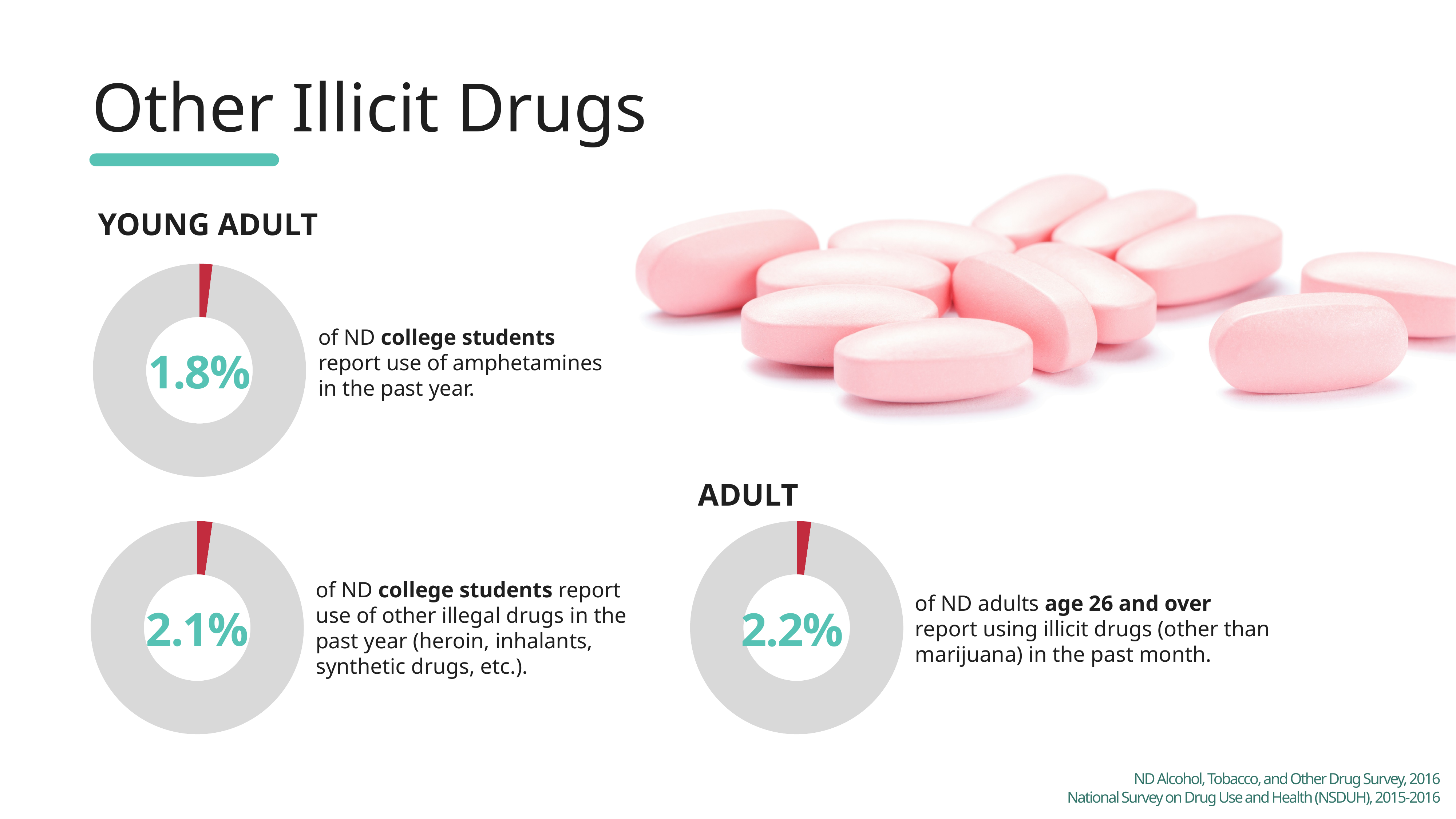
Of the three donut charts on the slide, which shows the highest percentage? The ADULT chart (2.2%) What is the difference in percentage points between the ADULT chart value (2.2%) and the top-left YOUNG ADULT amphetamine chart value (1.8%)? 0.4 percentage points How many donut charts are shown on the slide? 3 On the ADULT donut chart, what percentage of ND adults age 26 and over report using illicit drugs (other than marijuana) in the past month? 2.2% Is the value on the ADULT donut chart greater or less than 2%? greater What is the difference in percentage points between the two YOUNG ADULT donut charts (2.1% and 1.8%)? 0.3 percentage points Of the three donut charts on the slide, which shows the lowest percentage? The top-left YOUNG ADULT amphetamine chart (1.8%) Which is larger: the percentage of ND college students reporting amphetamine use (top-left chart) or the percentage of ND adults age 26 and over reporting illicit drug use (ADULT chart)? ND adults age 26 and over (2.2%) What kind of chart is used to show the percentages on this slide? Donut chart What colour is the small highlighted slice in each donut chart? Red On the top-left donut chart under YOUNG ADULT, what percentage of ND college students report use of amphetamines in the past year? 1.8% On the bottom-left donut chart under YOUNG ADULT, what percentage of ND college students report use of other illegal drugs in the past year? 2.1%